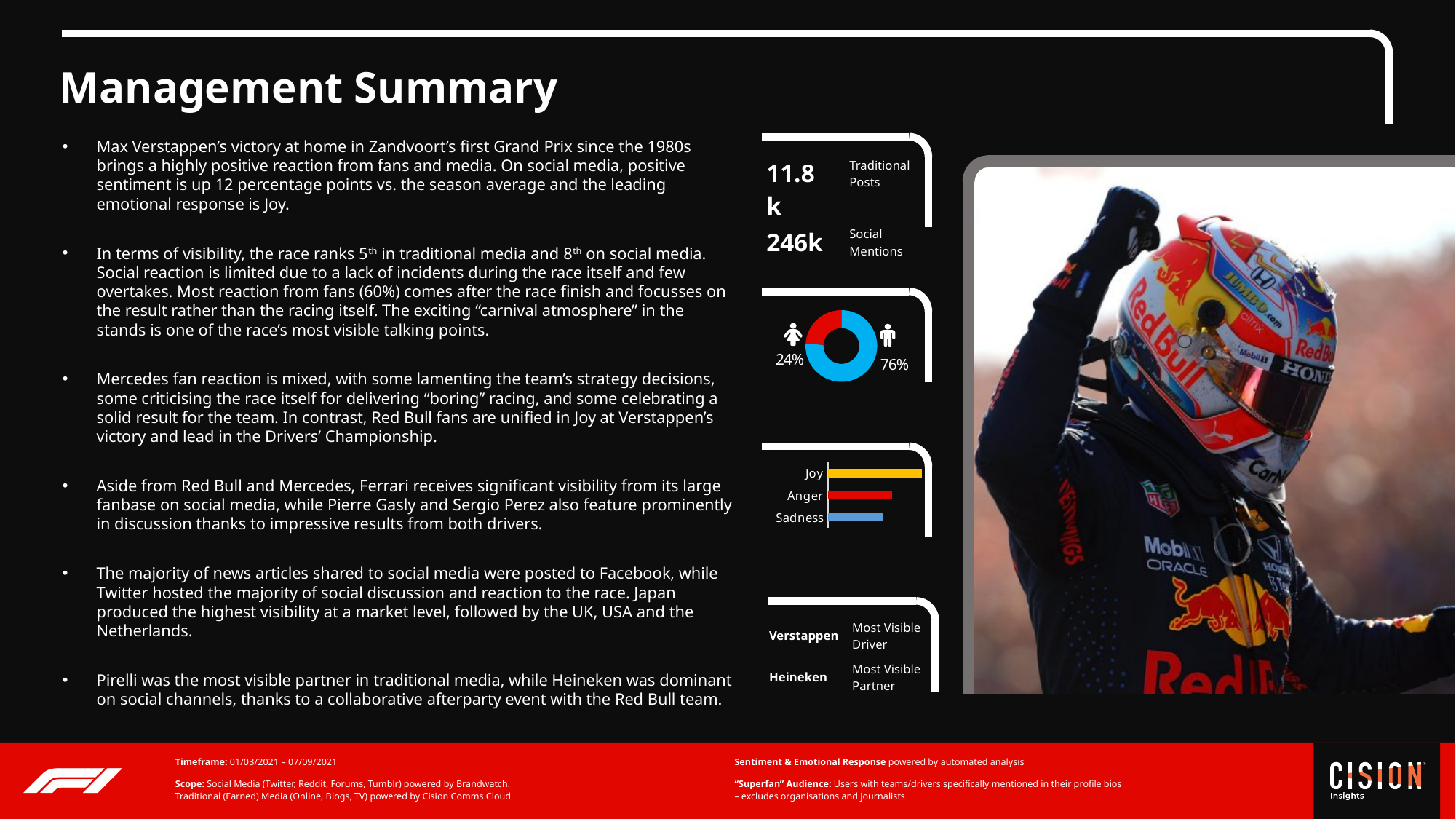
What kind of chart is used to show Joy, Anger and Sadness? bar chart In the donut chart, which segment is larger, the female or the male one? male In the donut chart, what is the difference in percentage points between the male and female shares? 52 What kind of chart shows the 24% and 76% split? donut chart In the emotions bar chart, what colour is the Joy bar? yellow In the emotions bar chart, which emotion has the longest bar? Joy In the donut chart, what share is shown for the female segment? 24% How many emotions are plotted in the emotions bar chart? 3 How many segments does the donut chart have? 2 In the emotions bar chart, which bar is longer, Anger or Sadness? Anger In the donut chart, what share is shown for the male segment? 76% In the emotions bar chart, which emotion has the shortest bar? Sadness